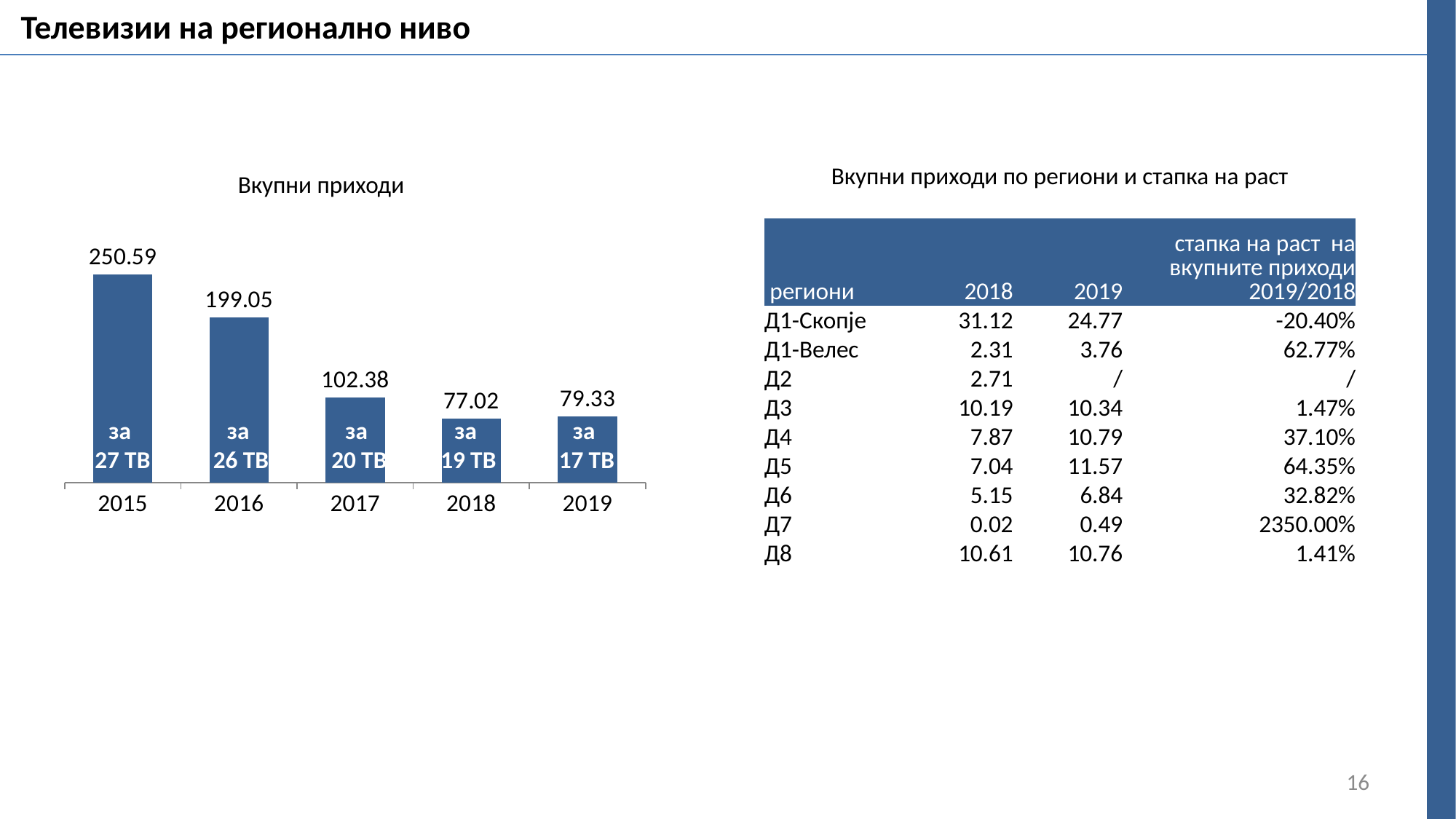
In the 'Вкупни приходи' chart, what is the value for 2015? 250.59 In the 'Вкупни приходи' chart, which year has the lowest value? 2018 What type of chart is 'Вкупни приходи'? bar chart In the 'Вкупни приходи' chart, which is larger, the value for 2016 or the value for 2017? 2016 In the 'Вкупни приходи' chart, what is the difference between the values for 2015 and 2016? 51.54 In the 'Вкупни приходи' chart, how many TV stations does the label inside the 2017 bar refer to? 20 ТВ How many years are shown in the 'Вкупни приходи' chart? 5 In the 'Вкупни приходи' chart, what is the value for 2017? 102.38 In the 'Вкупни приходи' chart, what is the value for 2019? 79.33 In the 'Вкупни приходи' chart, what is the difference between the values for 2019 and 2018? 2.31 In the 'Вкупни приходи' chart, which year has the highest value? 2015 In the 'Вкупни приходи' chart, do the values rise or fall from 2015 to 2018? fall